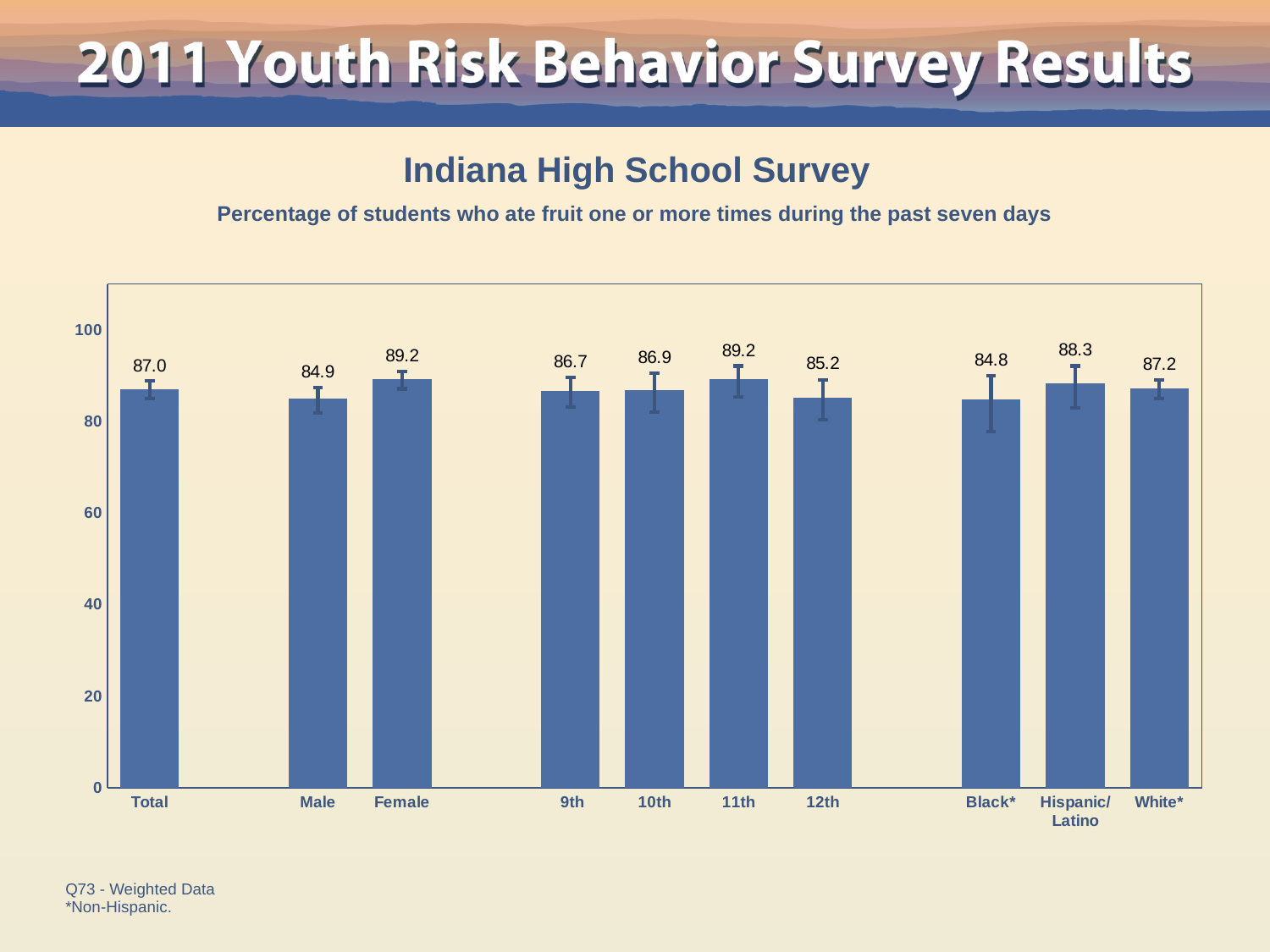
What is the value for 12th? 85.2 What is the difference between the values for Female and Male? 4.3 What kind of chart is shown on the slide? bar chart What is the value for Female? 89.2 Which is larger, the value for Female or the value for Male? Female What is the value for Total? 87.0 What is the difference between the values for 11th and 12th? 4.0 What is the value for Black*? 84.8 What is the subtitle describing what the chart measures? Percentage of students who ate fruit one or more times during the past seven days How many categories are shown on the x axis? 10 What is the value for Hispanic/Latino? 88.3 Is the value for 9th greater or less than 80? greater